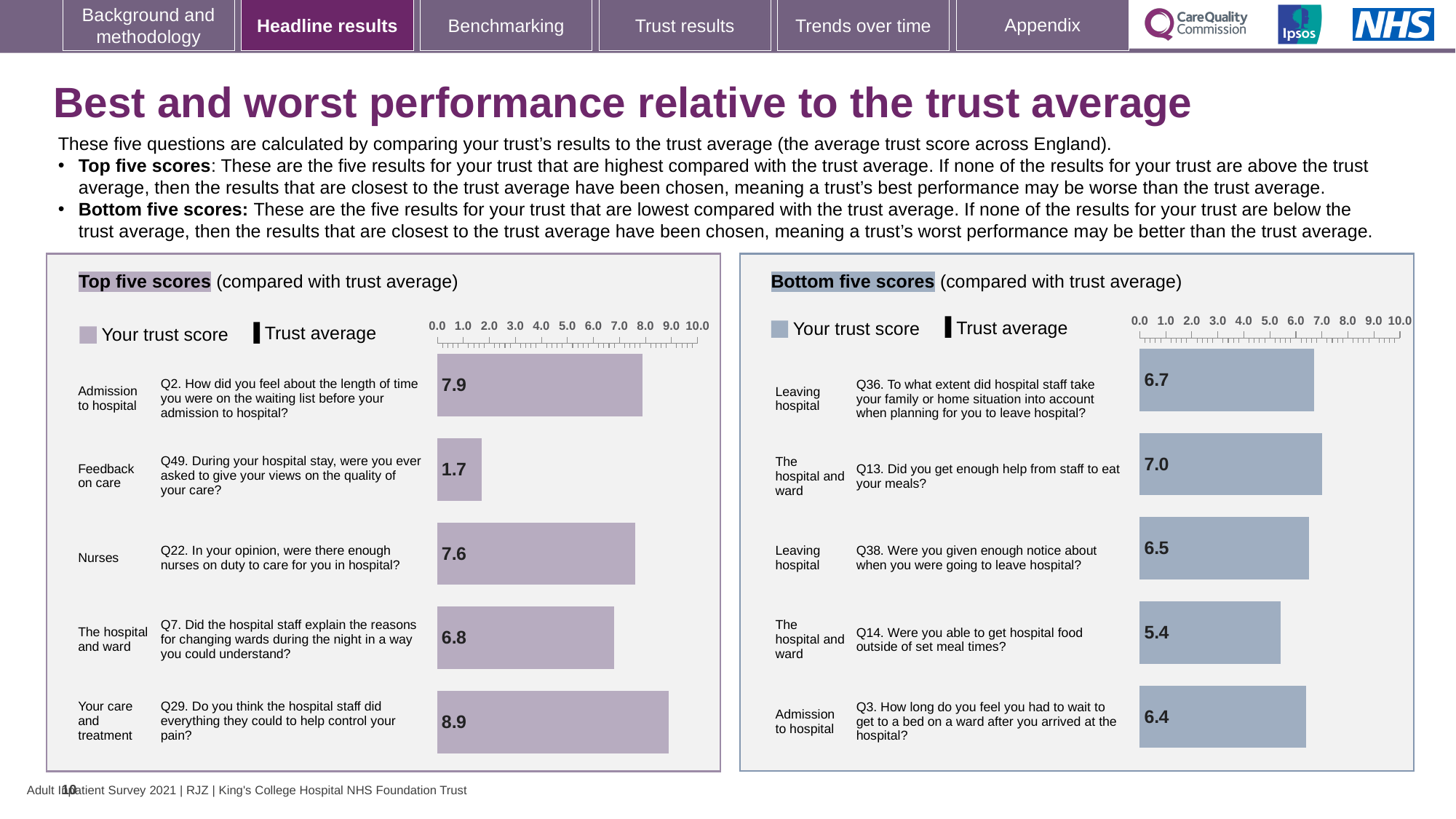
On the Top five scores chart, what is the difference between the trust scores for Q29 and Q7? 2.1 On the Bottom five scores chart, what is the trust score for Q3 (wait to get to a bed on a ward)? 6.4 On the Bottom five scores chart, which question has the lowest trust score? Q14 (hospital food outside of set meal times) On the Bottom five scores chart, which is larger: the trust score for Q36 or for Q38? Q36 How many bars are plotted on the Top five scores chart? 5 On the Top five scores chart, what is the trust score for Q2 (length of time on the waiting list before admission)? 7.9 On the Top five scores chart, what is the trust score for Q49 (asked to give your views on the quality of your care)? 1.7 What type of chart is used for the Bottom five scores? Bar chart On the Bottom five scores chart, what is the trust score for Q13 (enough help from staff to eat your meals)? 7.0 On the Bottom five scores chart, which question has the highest trust score? Q13 (enough help from staff to eat your meals) On the Top five scores chart, which question has the lowest trust score? Q49 (asked to give your views on the quality of your care) On the Top five scores chart, which question has the highest trust score? Q29 (help control your pain)